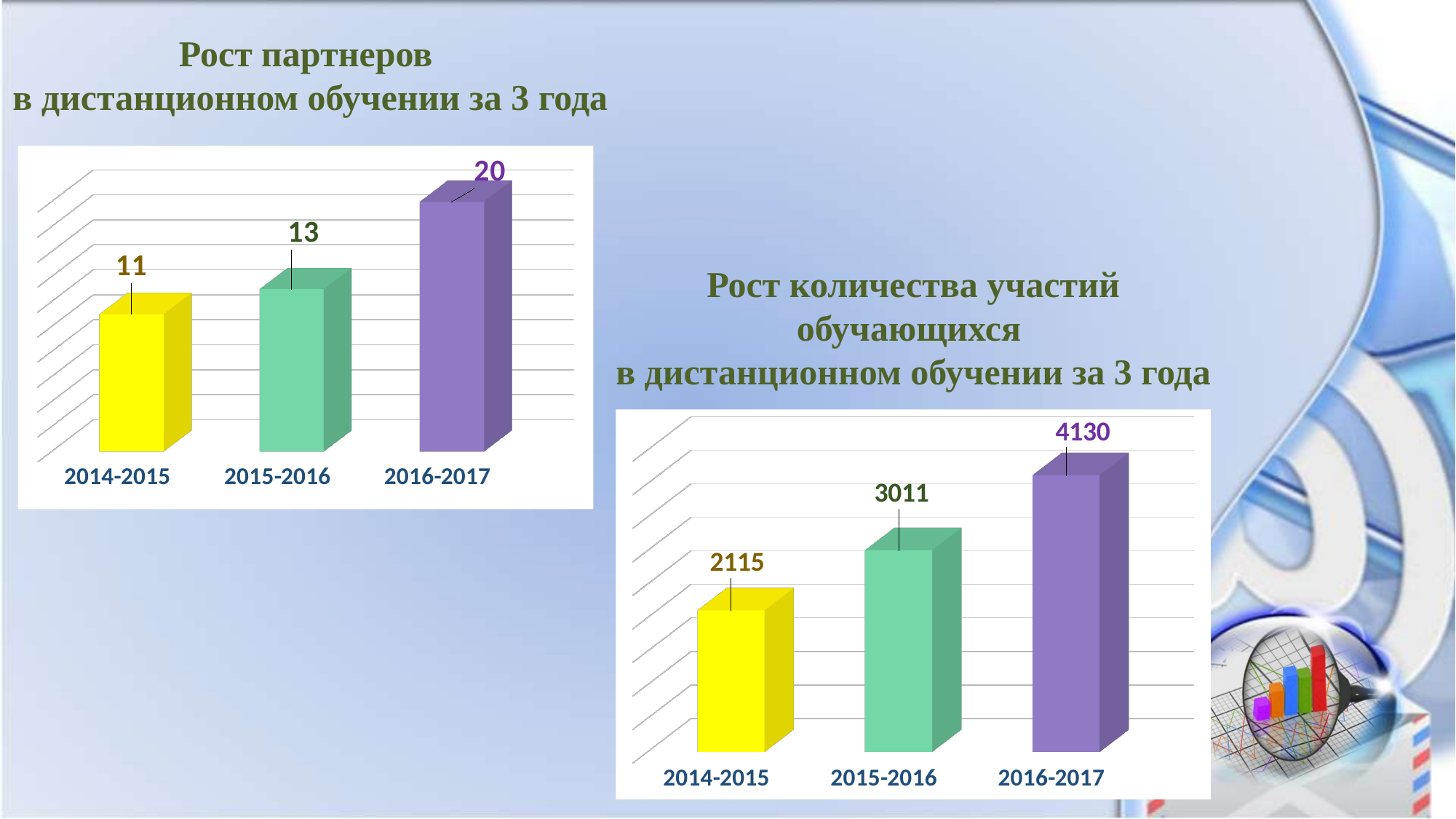
In the left chart (Рост партнеров), which year has the highest value? 2016-2017 In the left chart (Рост партнеров), what is the value for 2016-2017? 20 In the left chart (Рост партнеров), how many bars are plotted? 3 In the right chart (Рост количества участий обучающихся), which is larger: the value for 2015-2016 or 2014-2015? 2015-2016 In the left chart (Рост партнеров), what is the difference between the 2016-2017 and 2015-2016 values? 7 In the right chart (Рост количества участий обучающихся), what is the difference between the 2016-2017 and 2014-2015 values? 2015 In the left chart (Рост партнеров), do the values rise or fall from 2014-2015 to 2016-2017? rise In the left chart (Рост партнеров в дистанционном обучении за 3 года), what is the value for 2014-2015? 11 What type of chart is the right chart (Рост количества участий обучающихся)? bar chart In the right chart (Рост количества участий обучающихся), what is the value for 2016-2017? 4130 In the right chart (Рост количества участий обучающихся), what is the value for 2015-2016? 3011 In the right chart (Рост количества участий обучающихся), which year has the lowest value? 2014-2015